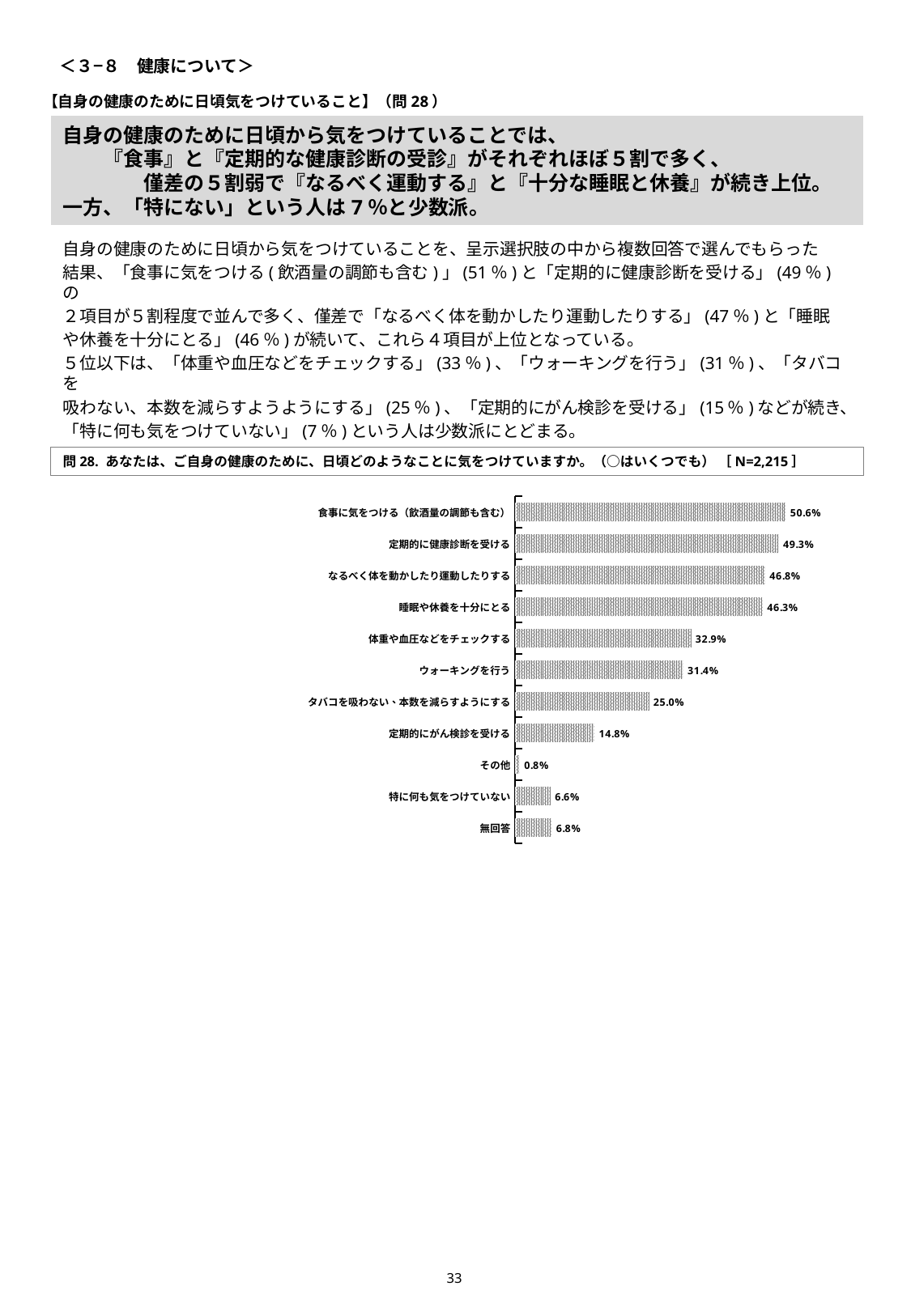
What kind of chart is shown? Bar chart What is the difference between 定期的に健康診断を受ける and 睡眠や休養を十分にとる? 3.0% What is the sample size (N) stated in the question box above the chart? N=2,215 What is the difference between 体重や血圧などをチェックする and タバコを吸わない、本数を減らすようにする? 7.9% What is the value for 定期的にがん検診を受ける? 14.8% What is the value for ウォーキングを行う? 31.4% What is the value for 食事に気をつける（飲酒量の調節も含む）? 50.6% Which is larger, なるべく体を動かしたり運動したりする or 睡眠や休養を十分にとる? なるべく体を動かしたり運動したりする Which category has the highest value? 食事に気をつける（飲酒量の調節も含む） How many categories are shown in the chart? 11 Which category has the lowest value? その他 What is the value for 無回答? 6.8%